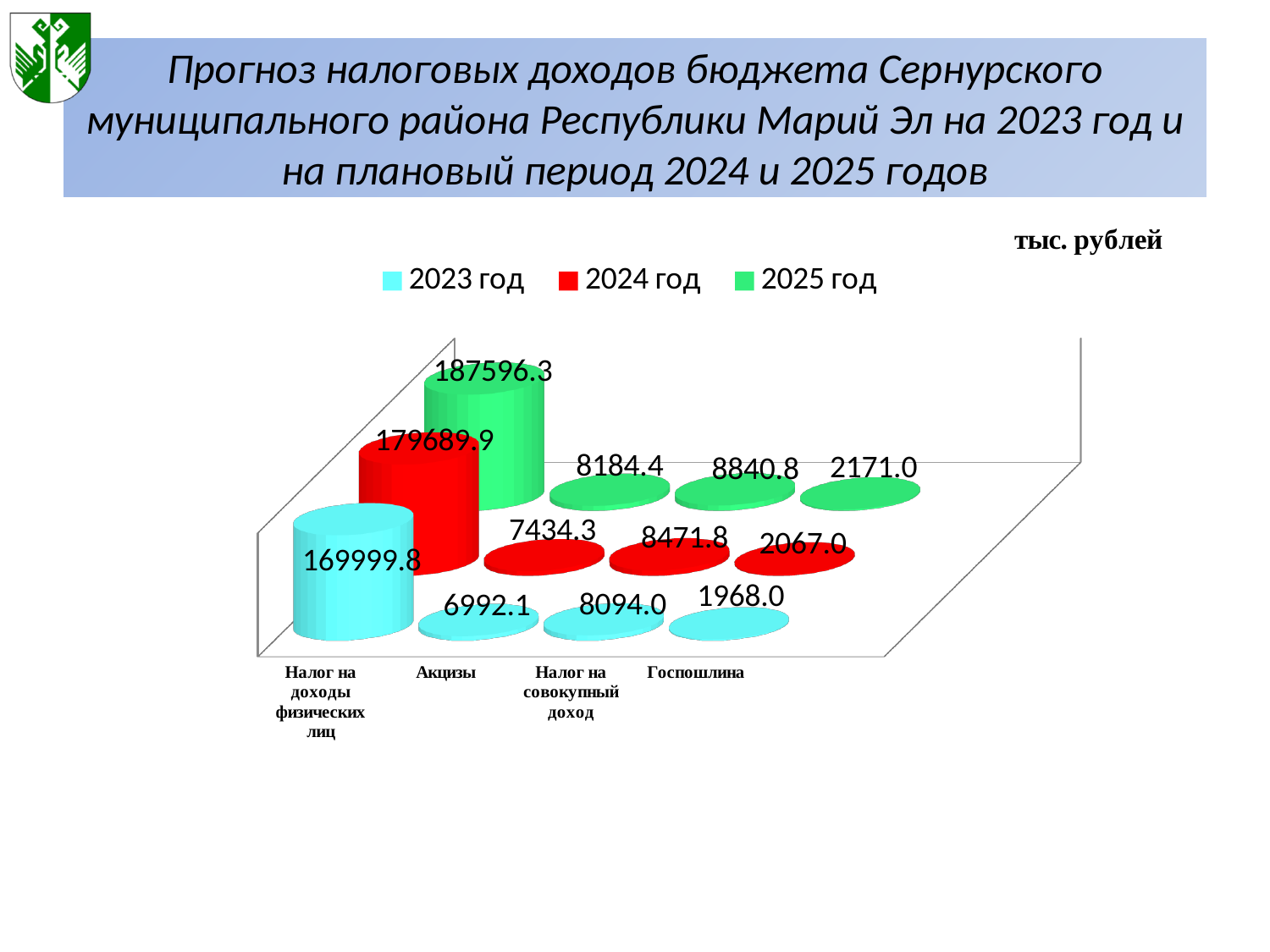
What is the value for Налог на доходы физических лиц in the 2023 год series? 169999.8 Do the values for Акцизы rise or fall from 2023 год to 2025 год? rise How many series does the legend list? 3 How many categories are shown on the x axis? 4 What is the value for Госпошлина in the 2025 год series? 2171.0 Which category has the lowest value in the 2024 год series? Госпошлина Which is larger in the 2023 год series: Акцизы or Налог на совокупный доход? Налог на совокупный доход What is the value for Налог на совокупный доход in the 2023 год series? 8094.0 Which category has the highest value in the 2025 год series? Налог на доходы физических лиц What is the value for Акцизы in the 2024 год series? 7434.3 What is the difference between the 2025 год and 2023 год values for Госпошлина? 203.0 What is the difference between the 2025 год and 2023 год values for Налог на доходы физических лиц? 17596.5